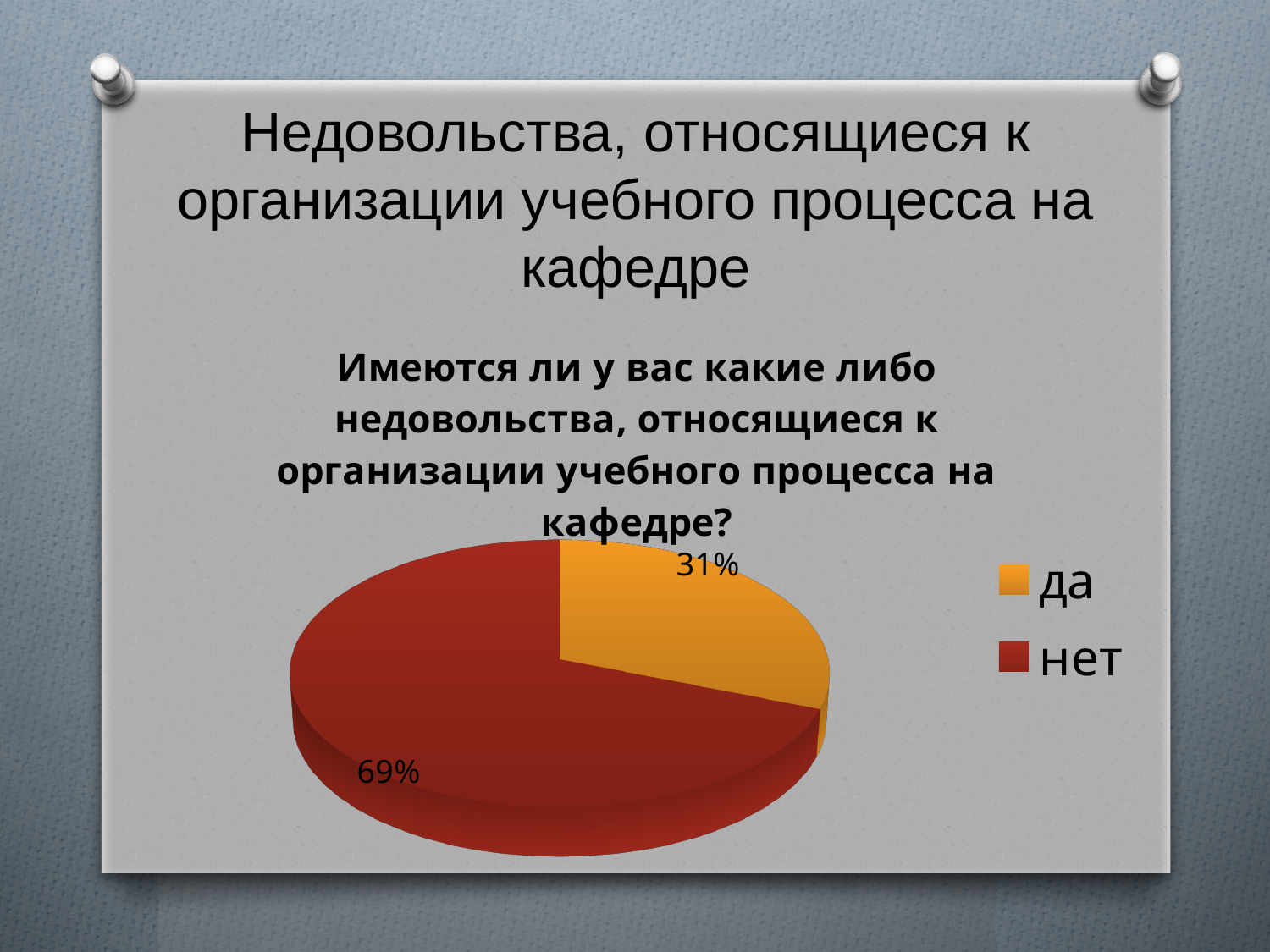
What colour is the slice for "да"? orange How many slices does the pie chart have? 2 What is the difference in percentage points between "нет" and "да"? 38 What type of chart is shown on the slide? pie chart Which answer has the smallest share of the pie? да Which is larger, the share for "да" or the share for "нет"? нет What is the total of the two slices shown? 100% What percentage of respondents answered "да"? 31% What percentage of respondents answered "нет"? 69% Which answer has the largest share of the pie? нет How many entries does the legend list? 2 What colour is the slice for "нет"? red